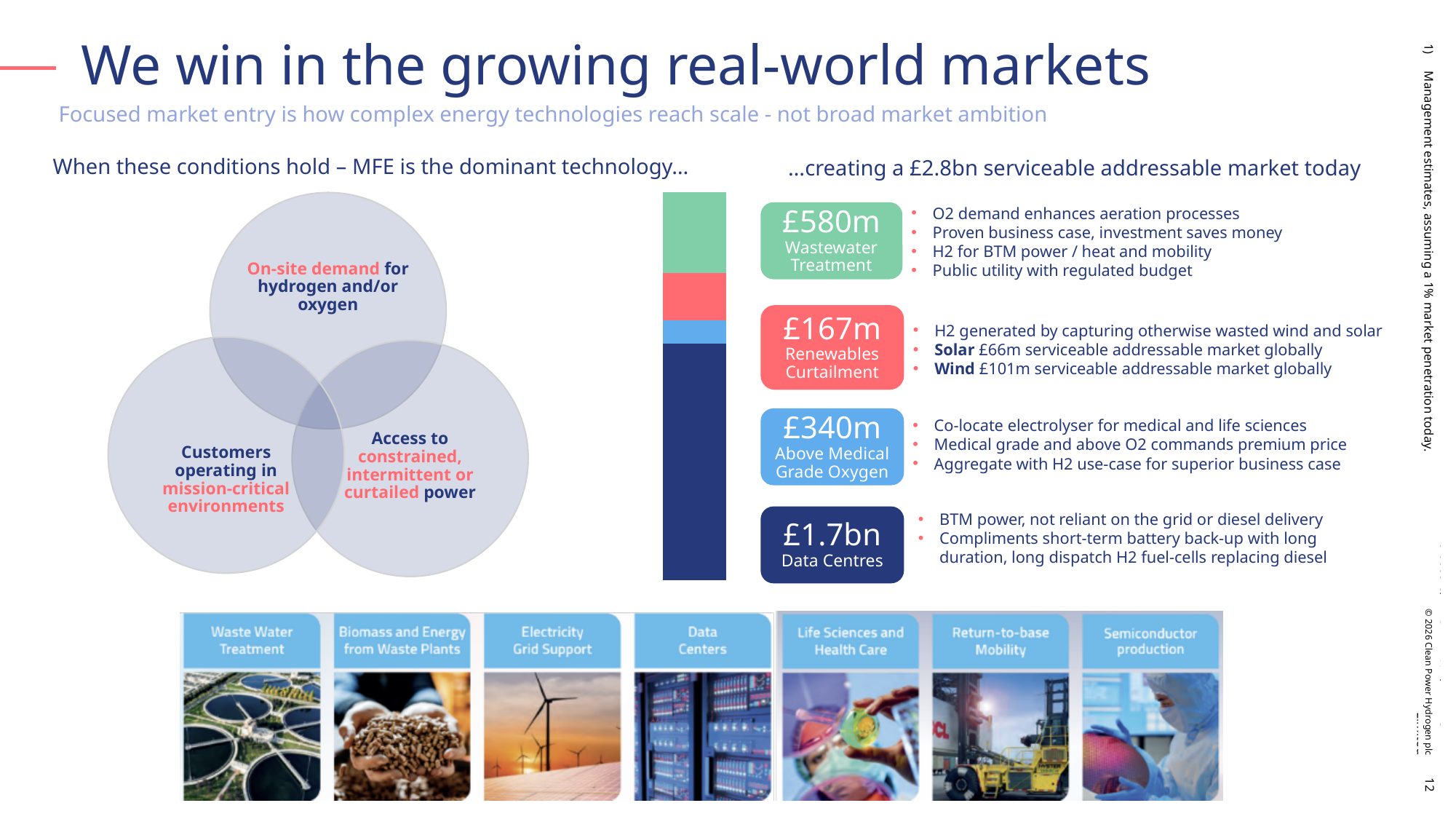
In the stacked bar chart, what is the value shown for Above Medical Grade Oxygen? £340m What kind of chart is shown next to the market segment labels? Stacked bar chart What is the difference between the Wastewater Treatment value and the Above Medical Grade Oxygen value in the stacked bar chart? £240m In the stacked bar chart, what is the serviceable addressable market value for Wastewater Treatment? £580m Which segment of the stacked bar chart has the smallest value? Renewables Curtailment Which segment of the stacked bar chart has the largest value? Data Centres What is the difference between the Wastewater Treatment value and the Renewables Curtailment value in the stacked bar chart? £413m How many market segments make up the stacked bar chart? 4 What total serviceable addressable market does the stacked bar chart represent, according to the heading above it? £2.8bn In the stacked bar chart, which is larger: Wastewater Treatment or Above Medical Grade Oxygen? Wastewater Treatment In the stacked bar chart, what is the value shown for Renewables Curtailment? £167m In the stacked bar chart, what is the value shown for Data Centres? £1.7bn